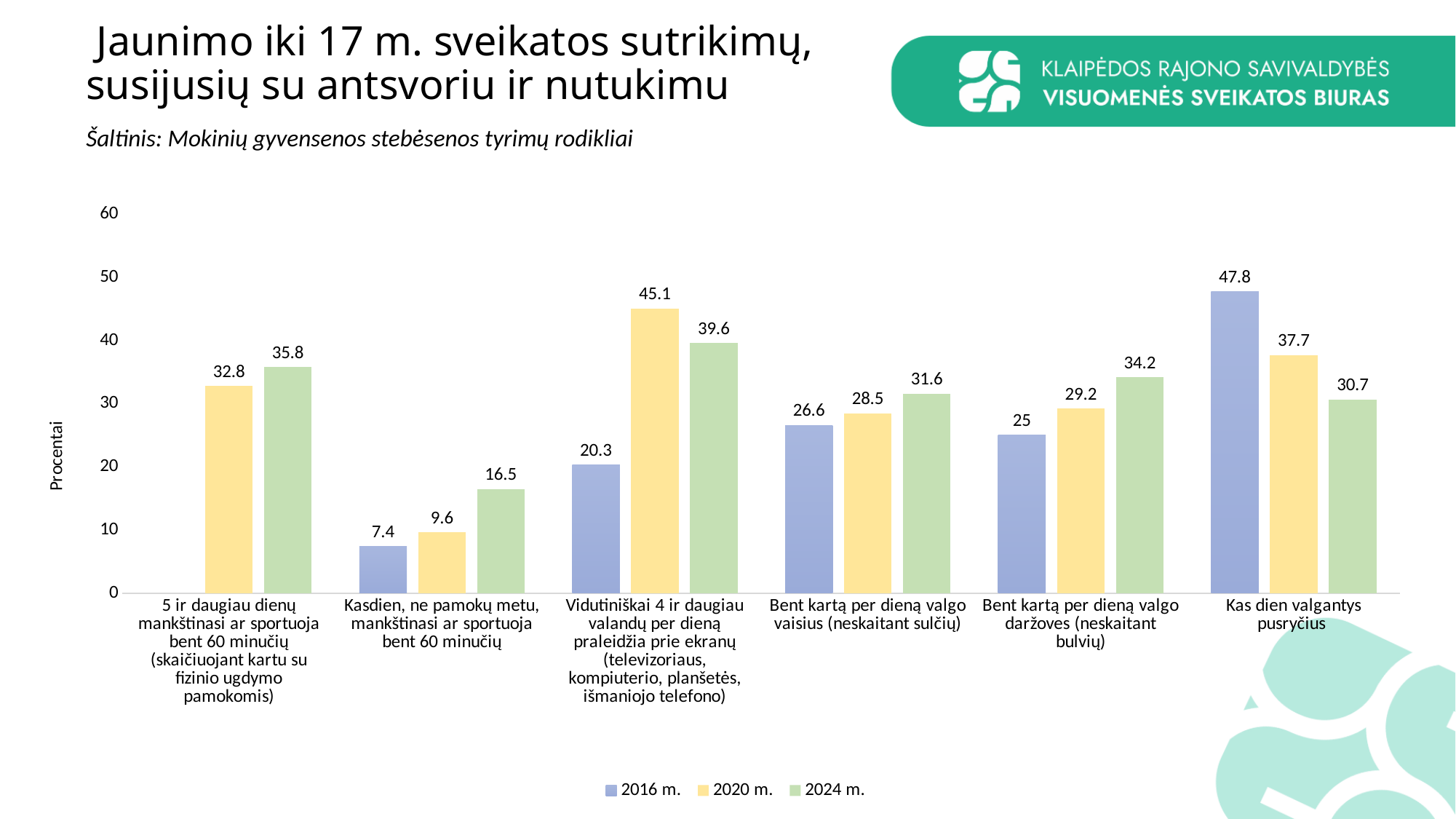
Do the values for "Kas dien valgantys pusryčius" rise or fall from 2016 m. to 2024 m.? fall Which category has the highest 2016 m. value? Kas dien valgantys pusryčius What is the difference between the 2024 m. and 2016 m. values for "Kasdien, ne pamokų metu, mankštinasi ar sportuoja bent 60 minučių"? 9.1 How many series does the legend list? 3 Is the 2020 m. value for "Kas dien valgantys pusryčius" greater or less than 40? less Which category has the lowest 2024 m. value? Kasdien, ne pamokų metu, mankštinasi ar sportuoja bent 60 minučių What is the 2016 m. value for "Bent kartą per dieną valgo daržoves (neskaitant bulvių)"? 25 What is the 2020 m. value for "Vidutiniškai 4 ir daugiau valandų per dieną praleidžia prie ekranų"? 45.1 What is the 2024 m. value for "Kas dien valgantys pusryčius"? 30.7 Which is larger for "Bent kartą per dieną valgo vaisius (neskaitant sulčių)": the 2016 m. value or the 2024 m. value? 2024 m. How many categories are shown on the x axis? 6 What kind of chart is shown on the slide? bar chart